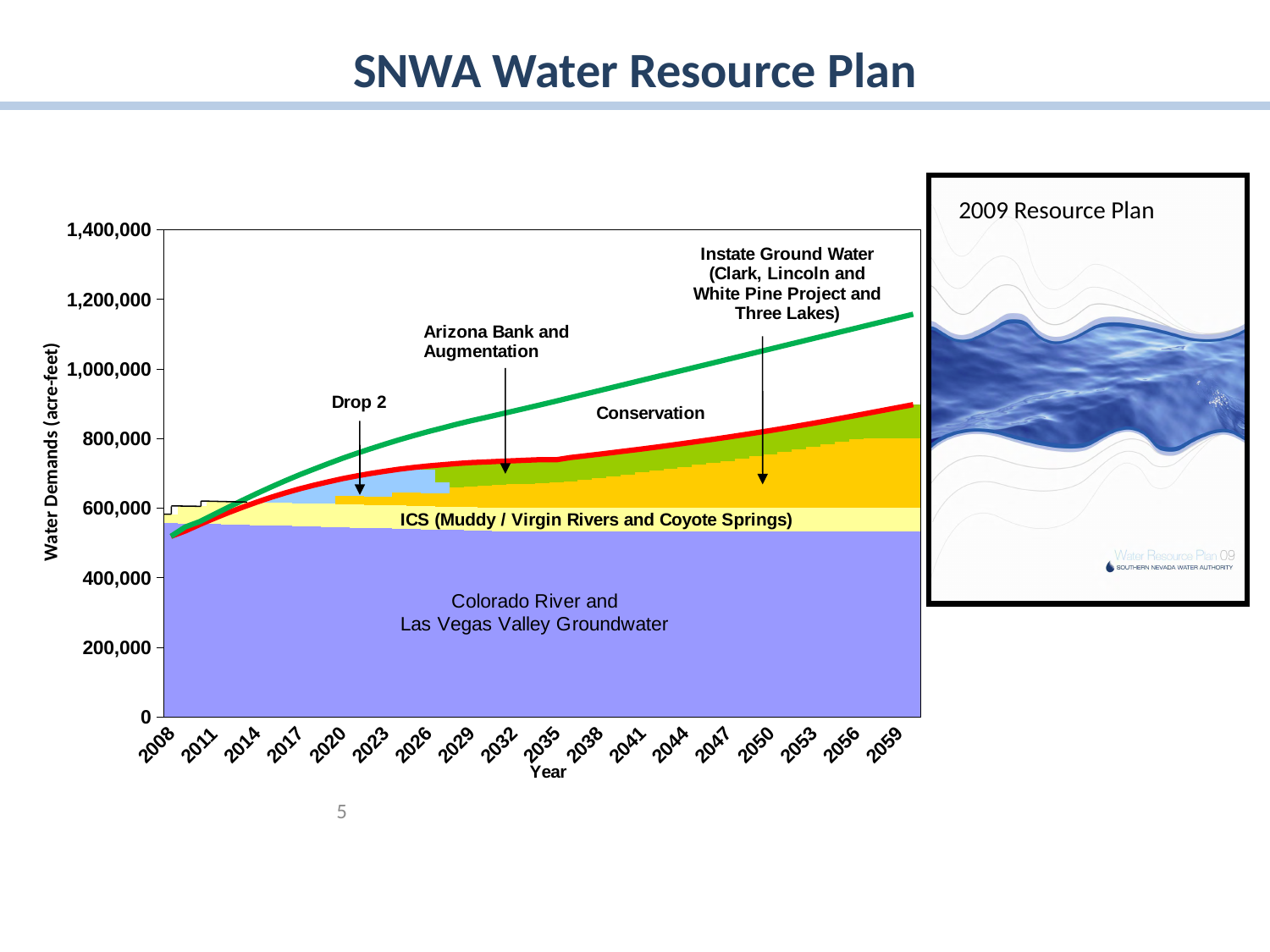
Does the green line rise or fall from 2008 to 2059? rise Is the top of the Colorado River and Las Vegas Valley Groundwater area in 2059 greater or less than 600,000? less What is the highest value shown on the y axis? 1,400,000 What kind of chart is shown on the slide? area chart In 2059, which is higher, the green line or the red line? the green line Is the value of the green line in 2020 greater or less than 800,000? less What is the label of the x axis of the chart? Year What is the label of the y axis of the chart? Water Demands (acre-feet) Is the value of the red line in 2059 greater or less than 1,000,000? less How many year labels are shown on the x axis? 18